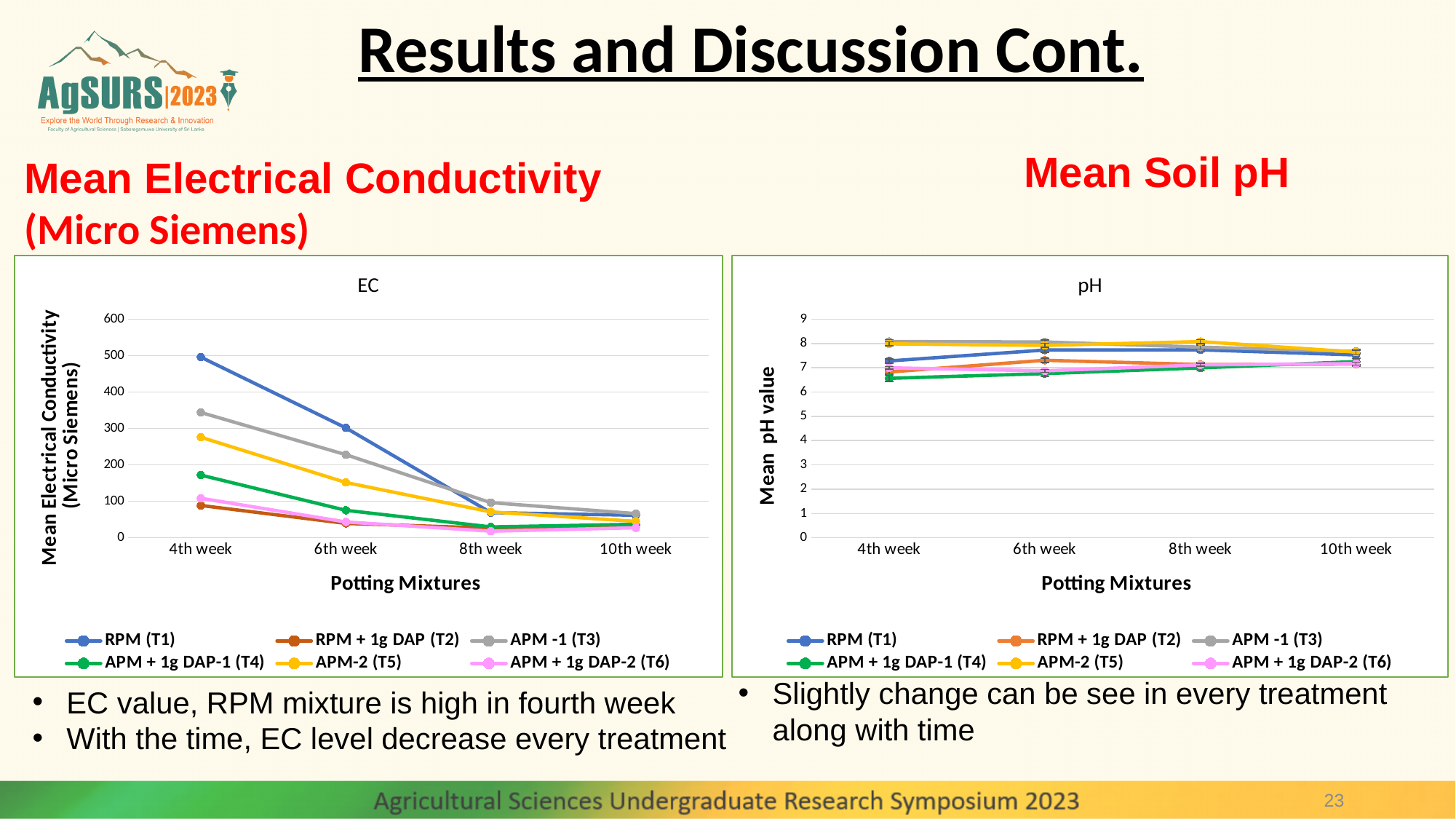
In the pH chart, is the value for APM-2 (T5) at the 4th week greater or less than 7? greater In the EC chart, is the value for APM-2 (T5) at the 4th week greater or less than 300? less How many series does the legend of the pH chart list? 6 How many week categories are shown on the x axis of the EC chart? 4 In the EC chart, does the RPM (T1) line rise or fall from the 4th week to the 10th week? Fall In the EC chart, is the value for RPM (T1) at the 4th week greater or less than 400? greater What is the x-axis title of the pH chart? Potting Mixtures What kind of chart is the EC chart on the left? Line chart In the EC chart, which is larger at the 6th week: RPM (T1) or APM -1 (T3)? RPM (T1) In the EC chart, which series has the highest value at the 4th week? RPM (T1)